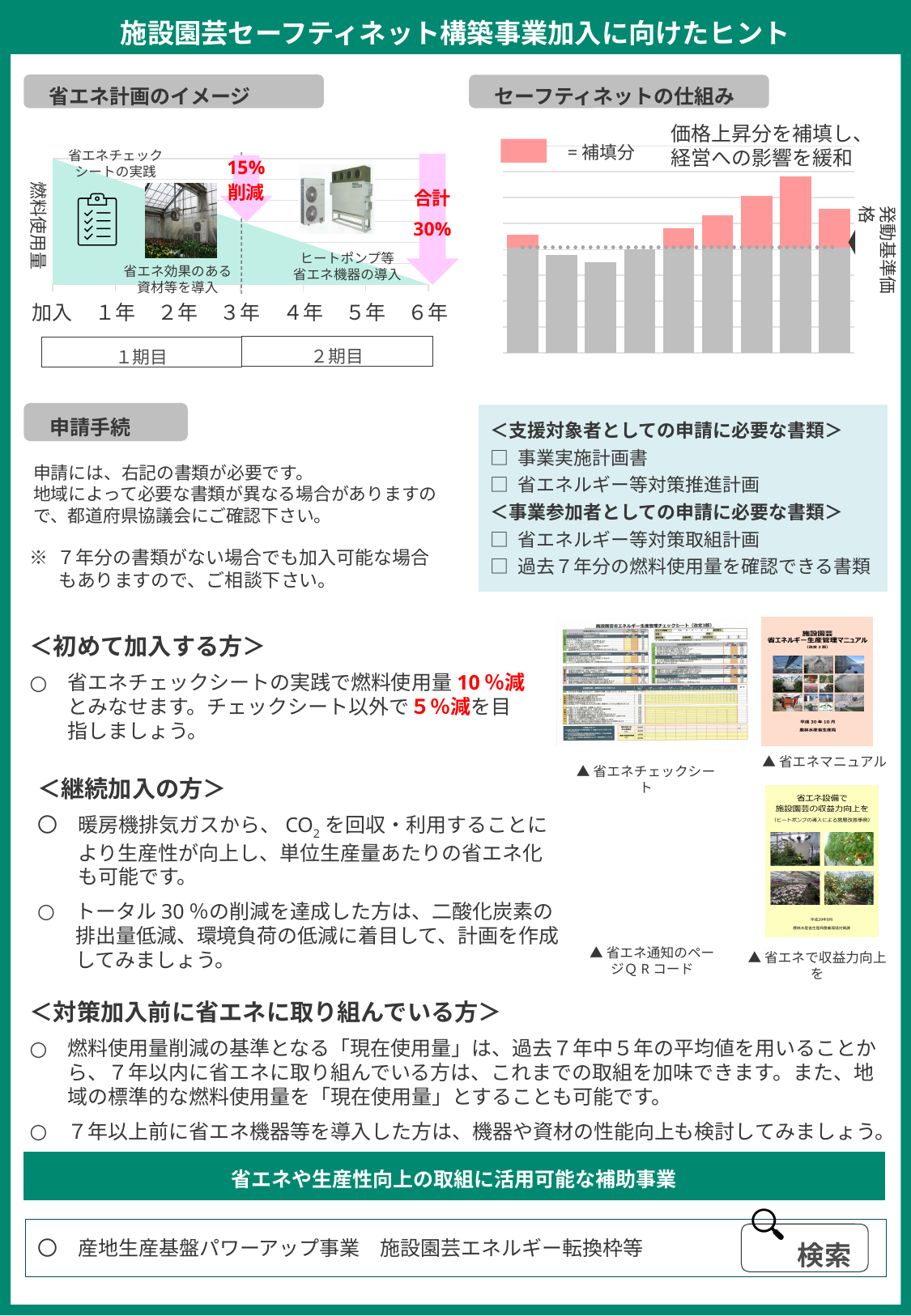
In the chart titled 「セーフティネットの仕組み」, which bar (counting from the left) is the shortest? the 3rd bar In the chart titled 「セーフティネットの仕組み」, what kind of chart is shown? bar chart In the chart titled 「セーフティネットの仕組み」, is the 2nd bar from the left taller or shorter than the 5th bar? shorter In the chart titled 「省エネ計画のイメージ」, what total reduction is indicated at 6年? 合計30% In the chart titled 「セーフティネットの仕組み」, how many bars rise above the 発動基準価格 dotted line (i.e. have a pink portion)? 6 In the chart titled 「セーフティネットの仕組み」, what does the pink colour represent according to the legend? 補填分 In the chart titled 「省エネ計画のイメージ」, what is the label on the vertical axis? 燃料使用量 In the chart titled 「省エネ計画のイメージ」, what reduction is indicated at the end of 1期目 (3年)? 15%削減 In the chart titled 「セーフティネットの仕組み」, how many bars are plotted? 9 In the chart titled 「省エネ計画のイメージ」, how many points are labelled along the horizontal axis (from 加入 to 6年)? 7 In the chart titled 「セーフティネットの仕組み」, which bar (counting from the left) is the tallest? the 8th bar In the chart titled 「省エネ計画のイメージ」, does fuel usage rise or fall from 加入 to 6年? fall